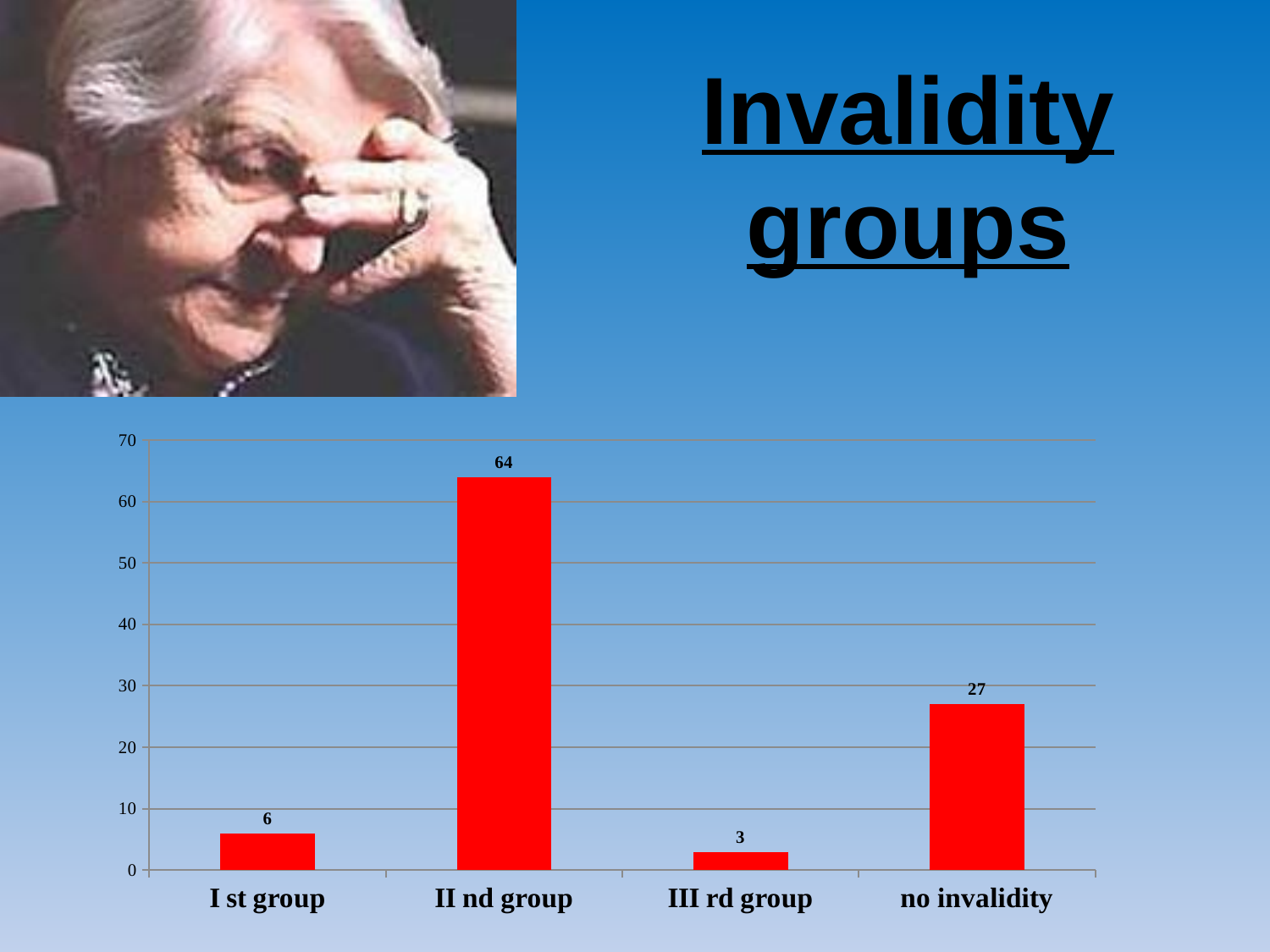
What is the value for the II nd group? 64 Which category has the highest value? II nd group What kind of chart is shown on the slide? bar chart Which is larger, the value for the I st group or the III rd group? I st group Is the value for no invalidity greater or less than 30? less What is the difference between the values for the II nd group and no invalidity? 37 What is the value for the I st group? 6 What is the title of the slide above the chart? Invalidity groups How many categories are shown on the x axis? 4 Which category has the lowest value? III rd group What is the value for the III rd group? 3 What is the value for no invalidity? 27